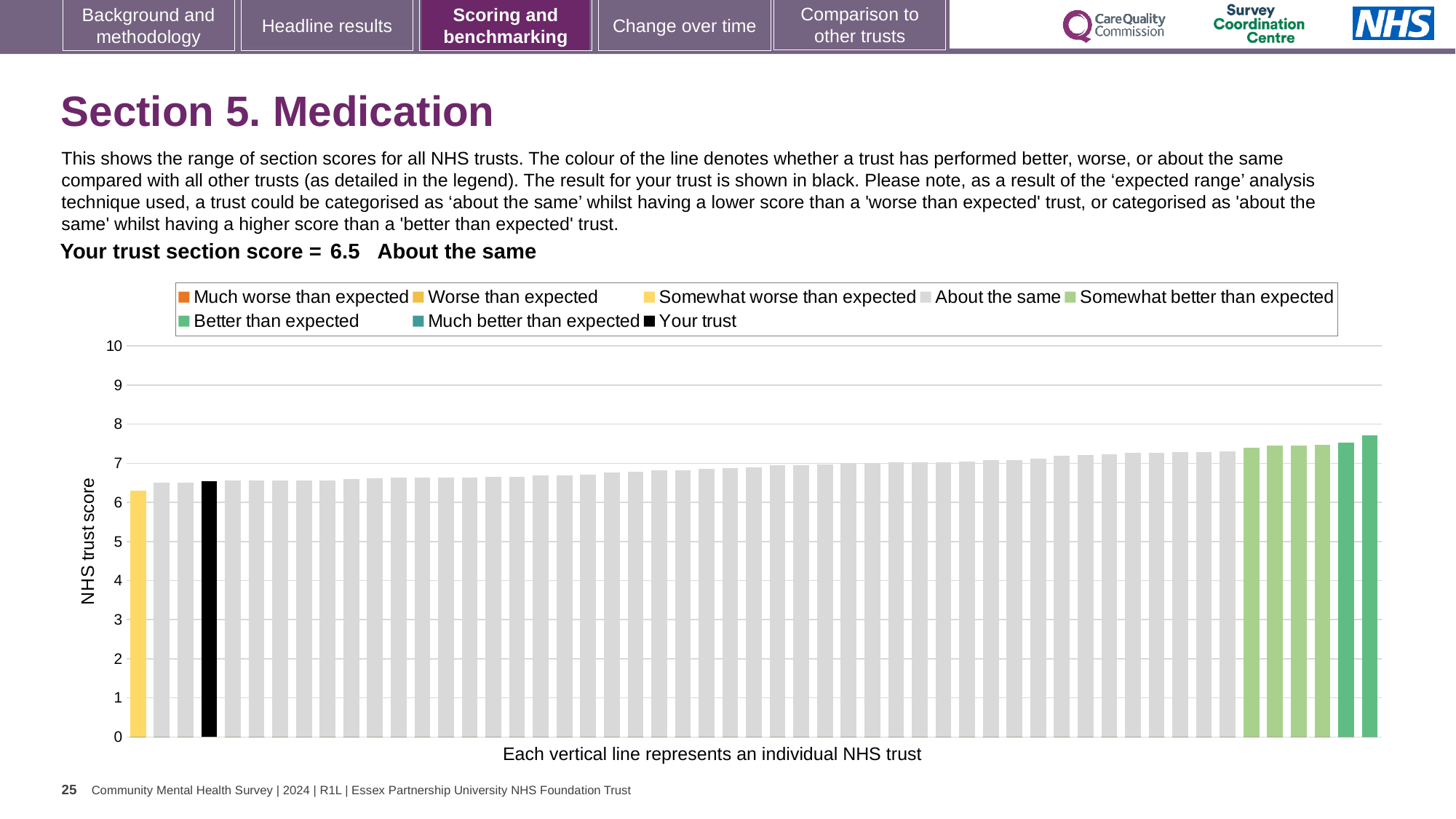
Which is larger, the value of the black bar or the value of the rightmost bar? the rightmost bar Is the value of the leftmost (yellow) bar greater or less than 6? greater Is the value of the rightmost bar greater or less than 7? greater What kind of chart is shown on the slide? bar chart Which is larger, the value of the leftmost yellow bar or the value of the black bar? the black bar What is the section score for your trust shown on the slide? 6.5 Is the value for your trust (the black bar) greater or less than 5? greater How many entries does the chart legend list? 8 According to the legend, what colour represents 'Your trust'? black Do the bar values rise or fall from left to right along the x axis? rise What is the label on the vertical axis of the chart? NHS trust score